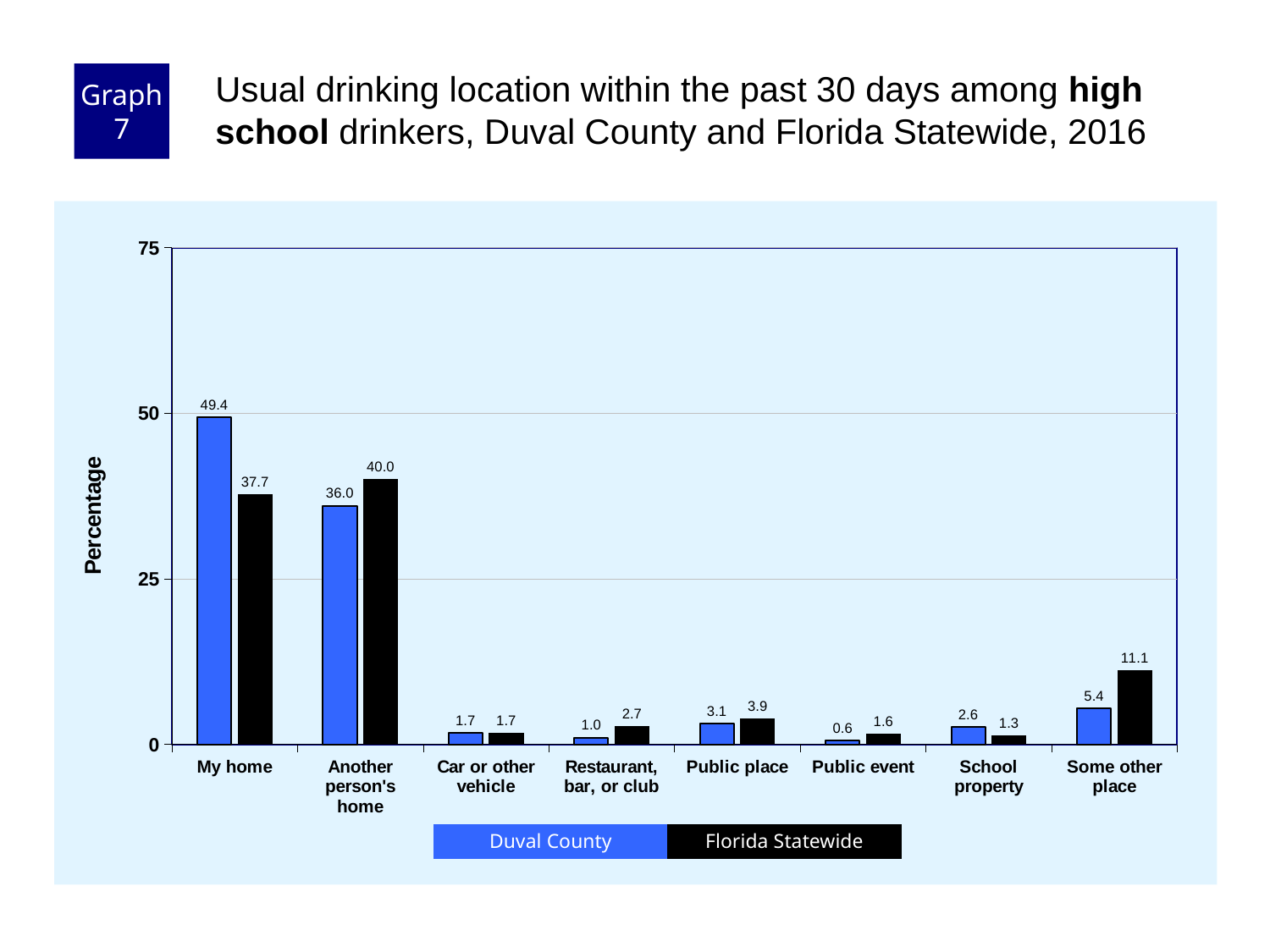
What is the Duval County value for Public event? 0.6 What is the Duval County value for My home? 49.4 What is the Florida Statewide value for Some other place? 11.1 Which category has the highest Duval County value? My home What is the Florida Statewide value for Another person's home? 40.0 What kind of chart is shown on the slide? Bar chart Is the Duval County value for Another person's home greater or less than 25? greater What is the difference between the Duval County and Florida Statewide values for My home? 11.7 How many categories are shown on the x axis? 8 Which category has the lowest Florida Statewide value? School property Which is larger for Some other place, Duval County or Florida Statewide? Florida Statewide How many series does the legend list? 2